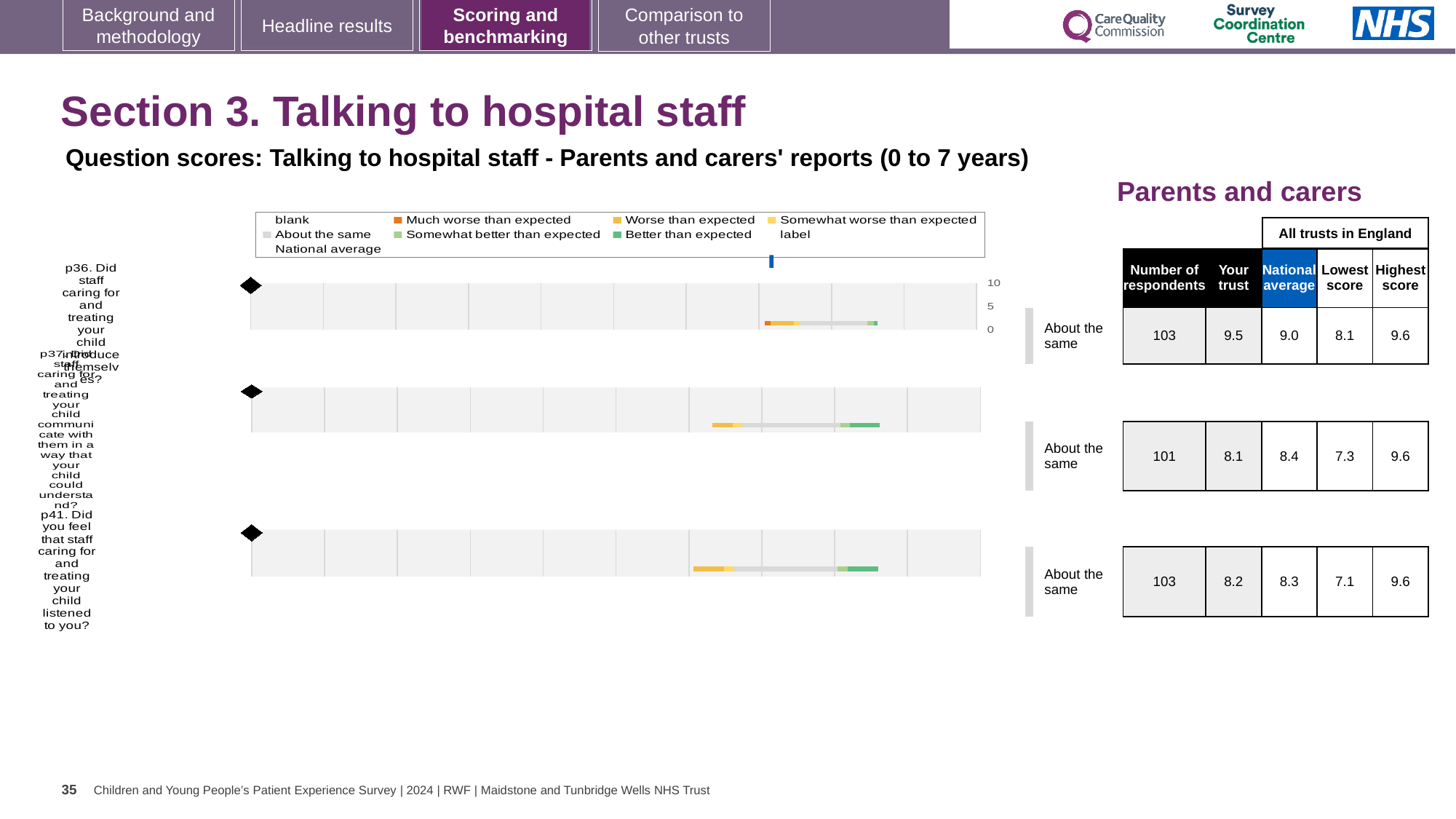
What is the lowest score among all trusts in England for p41 (Did you feel that staff listened to you)? 7.1 Which of the three questions has the lowest 'Lowest score' across all trusts in England? p41 How many entries does the chart legend list? 9 Which of the three questions has the highest 'Your trust' score? p36 What is the 'Your trust' score for p36 (Did staff caring for and treating your child introduce themselves)? 9.5 What kind of chart is used to show the question scores on this slide? bar chart Is the 'Your trust' score for p41 higher or lower than the national average? lower What is the national average score for p37 (Did staff communicate with your child in a way they could understand)? 8.4 How many respondents answered p37? 101 What is the difference between the 'Your trust' score and the national average for p36? 0.5 How many questions (categories) are plotted in the chart? 3 What benchmark category is shown for all three questions? About the same